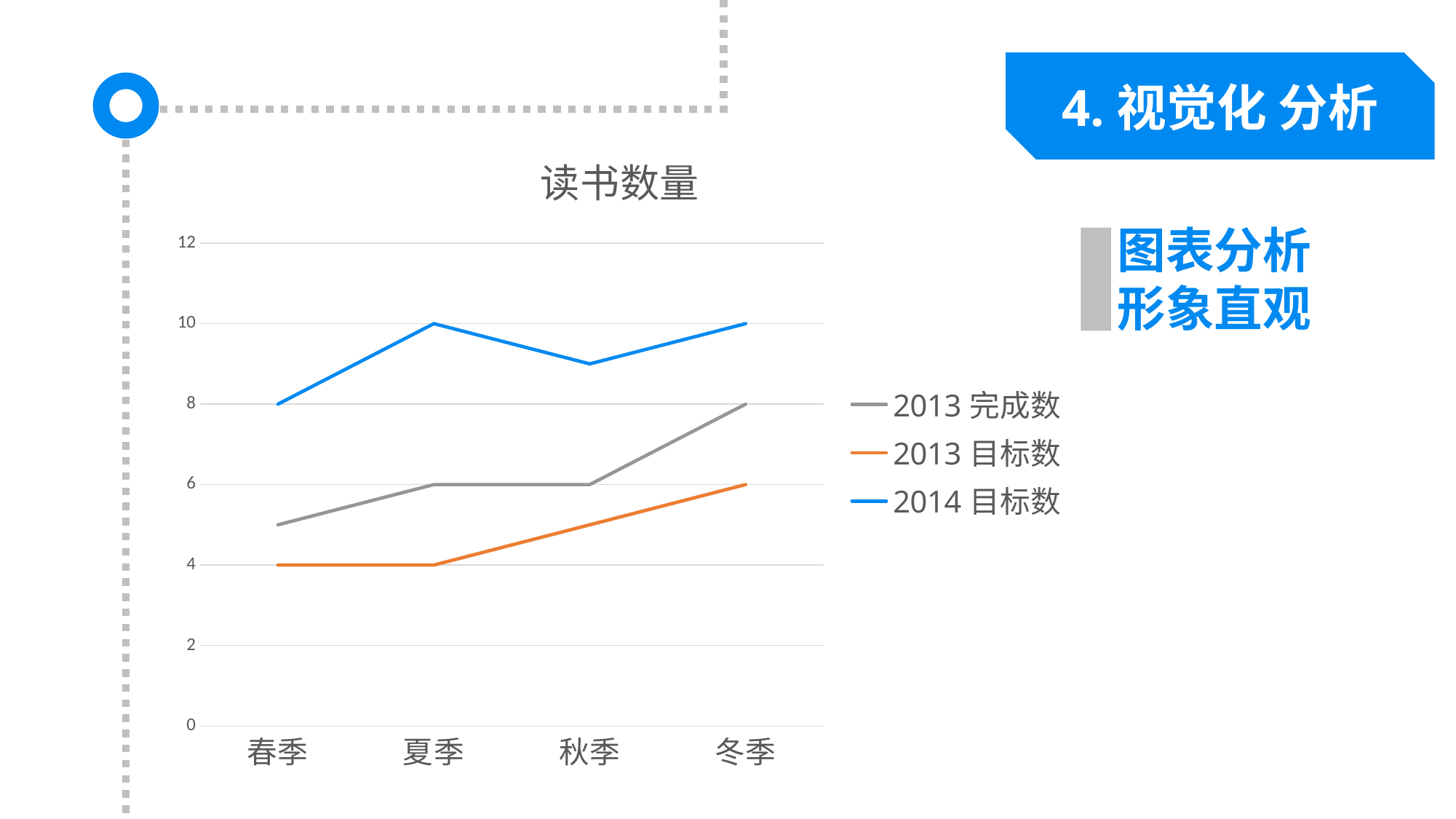
What is the value of 2014 目标数 for 夏季? 10 What is the value of 2013 完成数 for 冬季? 8 What kind of chart is shown on the slide? line chart Which season has the highest value for 2013 完成数? 冬季 What is the title of the chart? 读书数量 How many series does the legend list? 3 Is the value of 2014 目标数 for 秋季 greater or less than 8? greater Which season has the lowest value for 2014 目标数? 春季 What is the difference between 2014 目标数 and 2013 目标数 for 冬季? 4 Which is larger for 春季: 2014 目标数 or 2013 目标数? 2014 目标数 What is the value of 2013 目标数 for 春季? 4 How many categories are on the x axis? 4